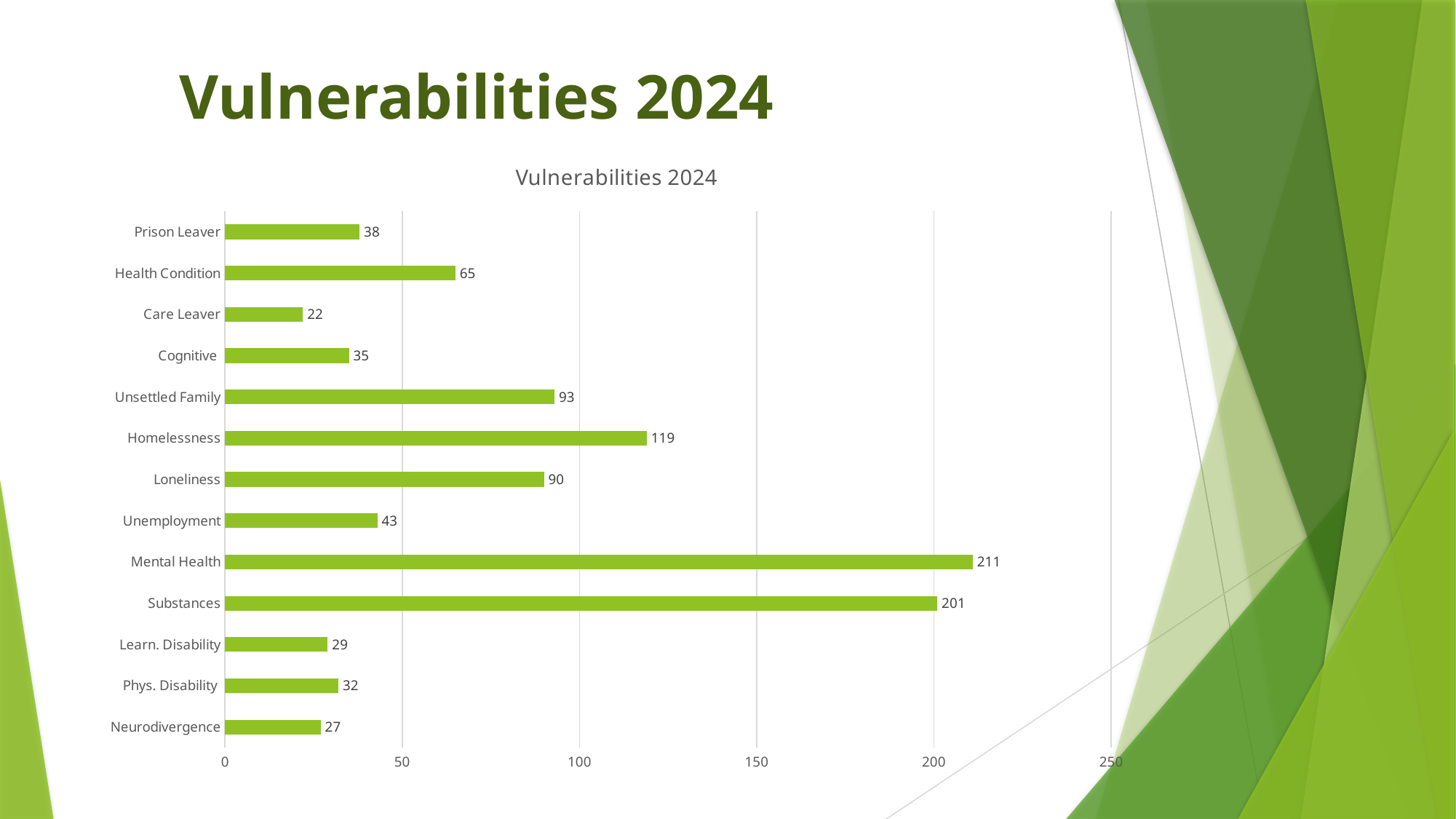
How many categories are shown in the chart? 13 What is the difference between Mental Health and Substances? 10 What is the value for Unsettled Family? 93 What is the value for Homelessness? 119 What kind of chart is shown on the slide? Bar chart Which is larger, Health Condition or Unemployment? Health Condition Which category has the lowest value? Care Leaver Is the value for Substances greater or less than 150? greater What is the title of the chart? Vulnerabilities 2024 What is the value for Care Leaver? 22 What is the difference between Homelessness and Loneliness? 29 Which category has the highest value? Mental Health